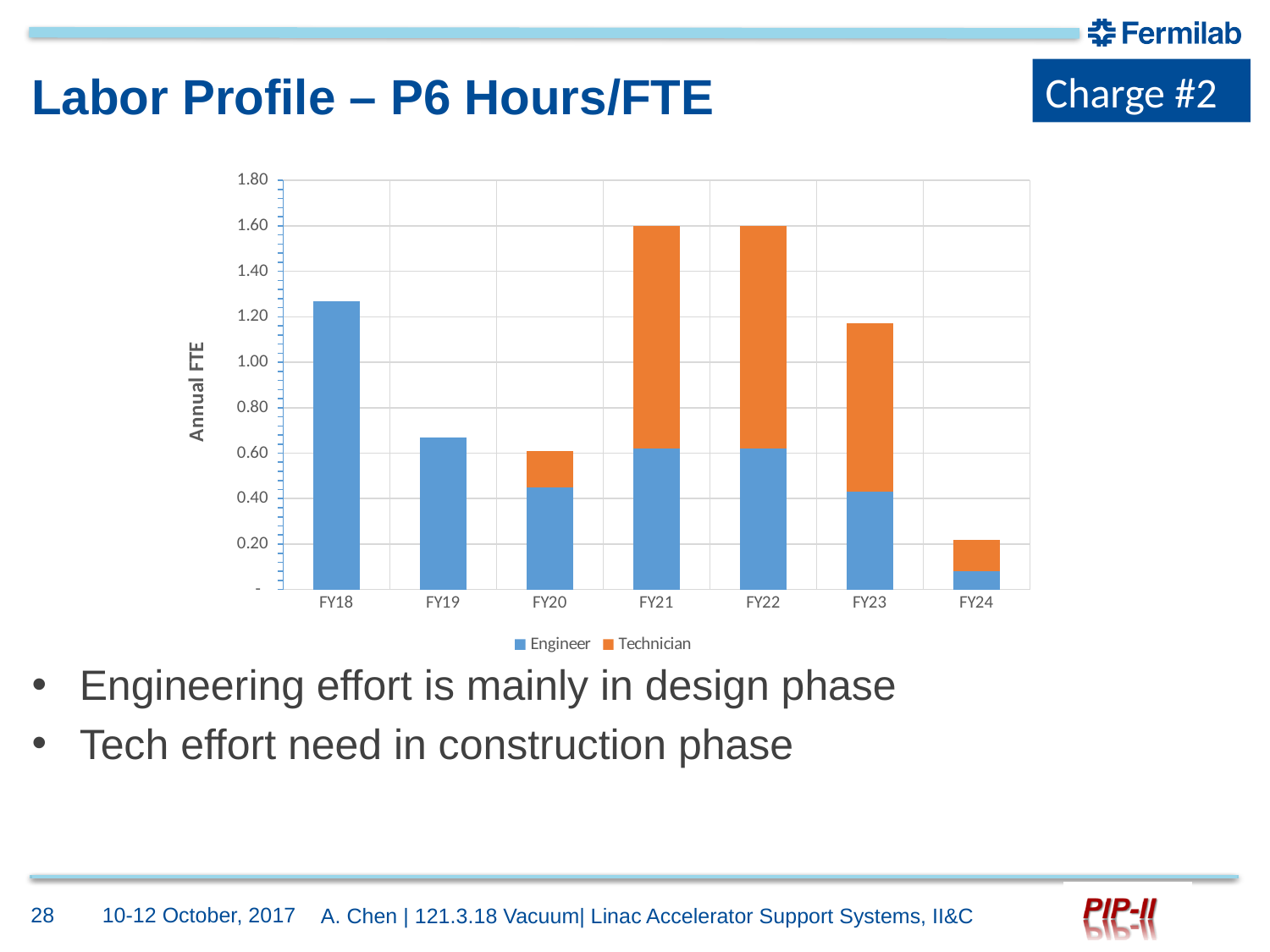
Is the total bar height for FY23 greater or less than 1.00? greater Is the total bar height for FY24 greater or less than 0.40? less Is the value for FY19 greater or less than 0.80? less How many fiscal years are shown on the x axis? 7 How many series does the legend list? 2 Which fiscal year has the lowest total bar? FY24 Which has the larger total bar, FY18 or FY19? FY18 Which fiscal year has the largest Engineer value? FY18 What is the label on the vertical axis? Annual FTE What kind of chart is shown on the slide? Stacked bar chart What are the two series named in the legend? Engineer and Technician